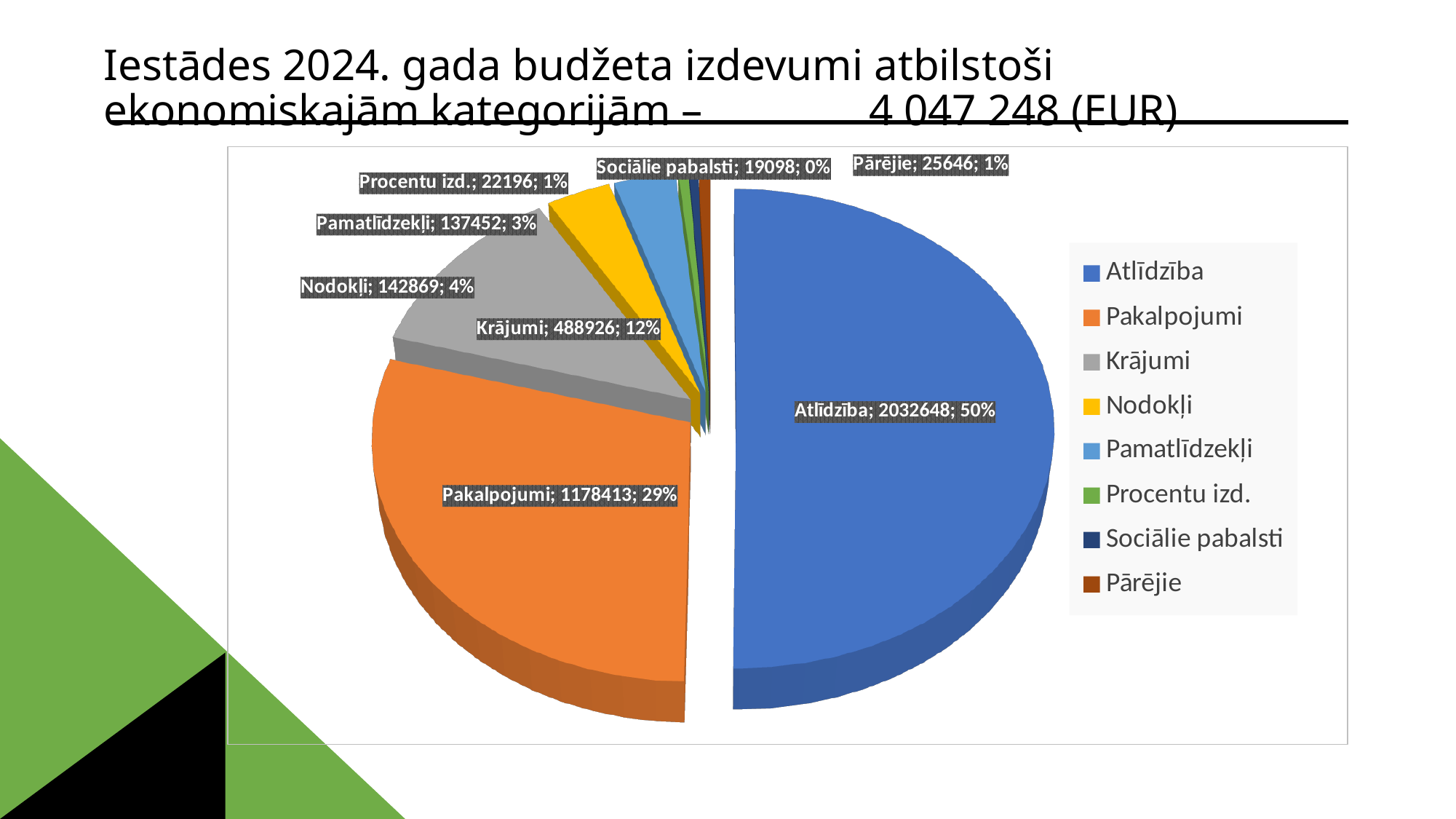
What is the difference between the values for Atlīdzība and Pakalpojumi? 854235 How many categories are shown in the pie chart? 8 Which category has the smallest value? Sociālie pabalsti What is the value for Pamatlīdzekļi? 137452 What is the total budget amount stated in the slide title? 4 047 248 (EUR) What is the value for Atlīdzība? 2032648 What is the difference between the values for Nodokļi and Pamatlīdzekļi? 5417 What share of the pie does Pakalpojumi represent? 29% What is the value for Krājumi? 488926 Which is larger, the value for Pārējie or the value for Procentu izd.? Pārējie Which category has the largest value? Atlīdzība What kind of chart is shown on the slide? Pie chart